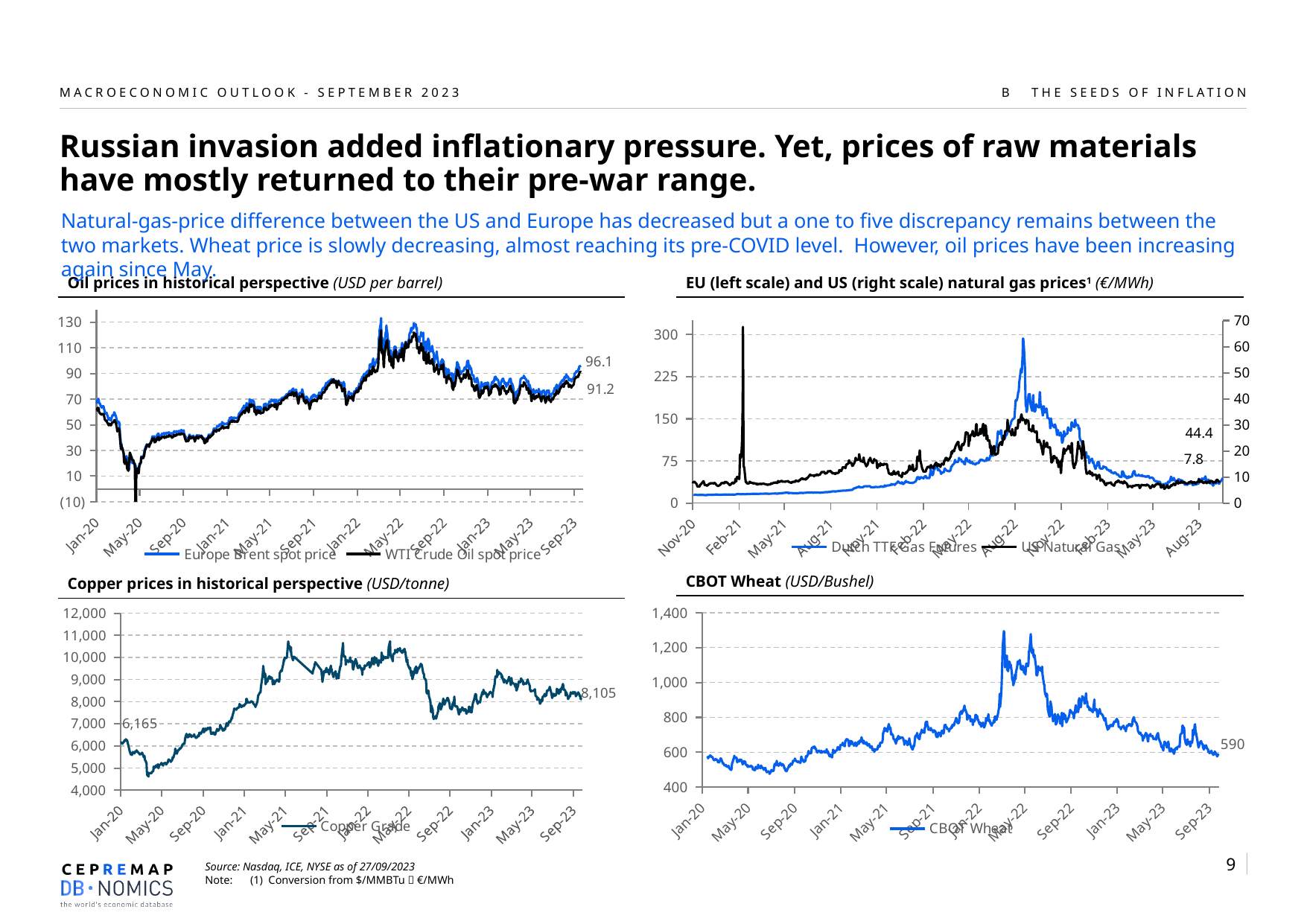
In the 'Oil prices in historical perspective' chart, what is the latest labelled value for the WTI Crude Oil spot price? 91.2 In the 'Copper prices in historical perspective' chart, what is the labelled value at the start of the series? 6,165 In the 'CBOT Wheat' chart, what is the latest labelled value? 590 In the 'Oil prices in historical perspective' chart, what is the difference between the latest labelled Brent value and the latest labelled WTI value? 4.9 How many series does the legend of the 'Oil prices in historical perspective' chart list? 2 How many series does the legend of the 'EU (left scale) and US (right scale) natural gas prices' chart list? 2 In the 'Oil prices in historical perspective' chart, which series has the higher latest labelled value, Europe Brent spot price or WTI Crude Oil spot price? Europe Brent spot price In the 'Copper prices in historical perspective' chart, what is the labelled value at the end of the series? 8,105 In the 'Oil prices in historical perspective' chart, what is the latest labelled value for the Europe Brent spot price? 96.1 What kind of chart is the 'CBOT Wheat' chart? Line chart In the 'CBOT Wheat' chart, is the peak value greater or less than 1,200? greater In the 'Copper prices in historical perspective' chart, what is the difference between the labelled end value and the labelled start value? 1,940